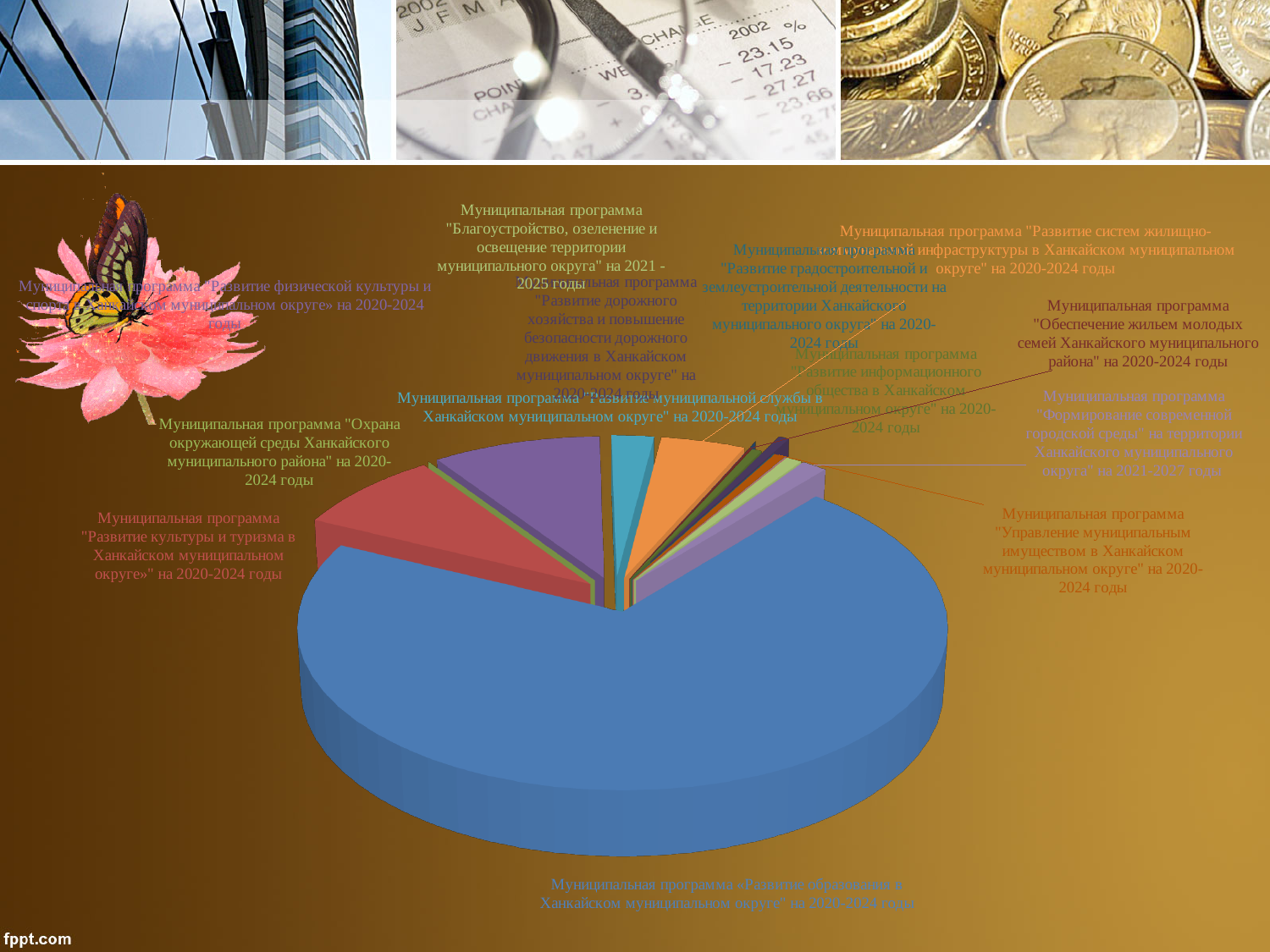
Which municipal program has the largest slice of the pie chart? Муниципальная программа «Развитие образования в Ханкайском муниципальном округе» на 2020-2024 годы What kind of chart is shown on the slide? Pie chart What colour is the largest slice of the pie chart? Blue Which slice is larger: the one for «Развитие образования в Ханкайском муниципальном округе» or the one for «Обеспечение жильем молодых семей Ханкайского муниципального района»? «Развитие образования в Ханкайском муниципальном округе» Which slice is larger: the one for «Развитие образования в Ханкайском муниципальном округе» or the one for «Развитие культуры и туризма в Ханкайском муниципальном округе»? «Развитие образования в Ханкайском муниципальном округе» Are numeric data values printed on the pie chart slices? No